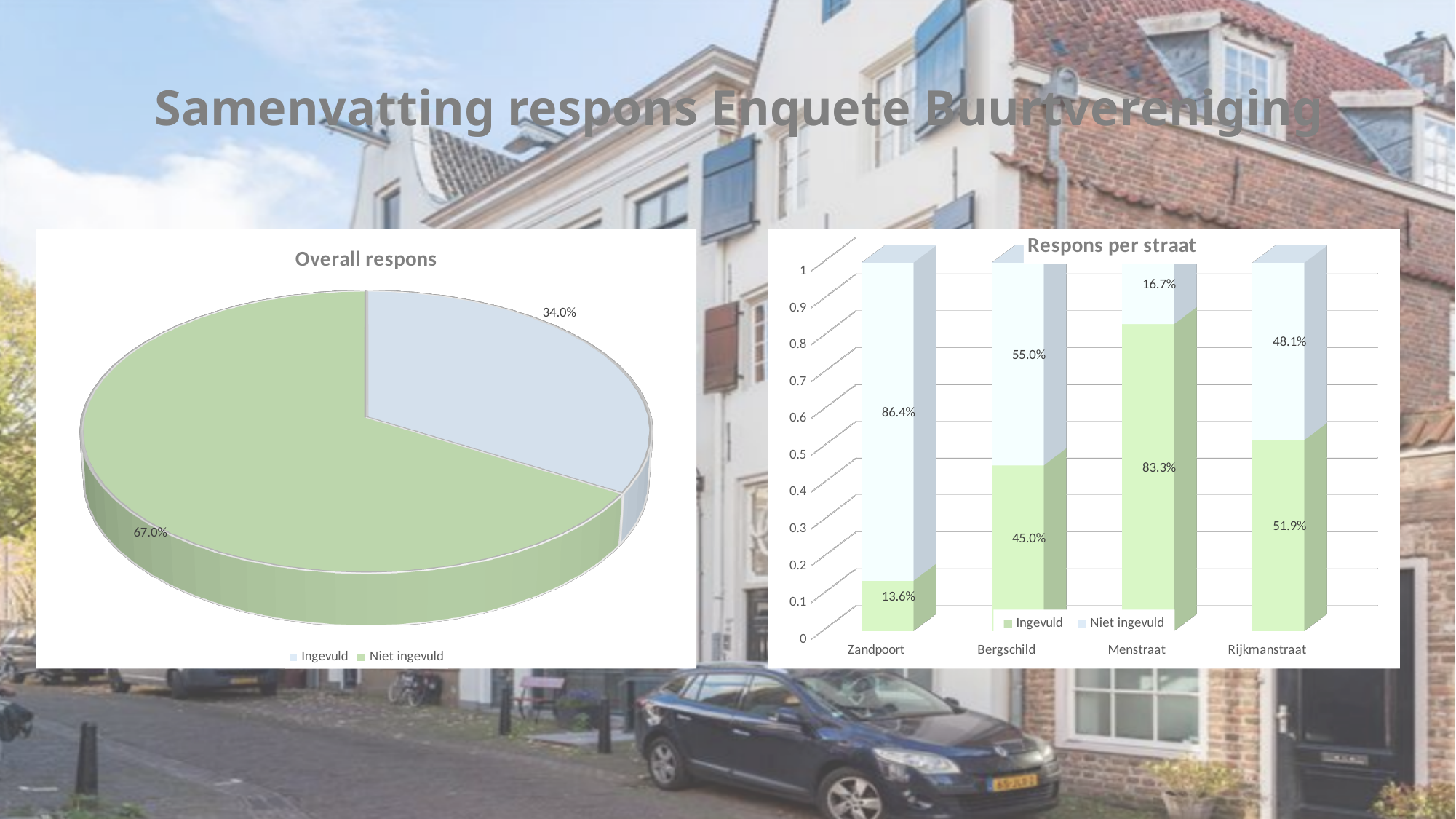
In the 'Respons per straat' chart, what is the Ingevuld value for Menstraat? 83.3% How many series does the legend of the 'Respons per straat' chart list? 2 In the 'Overall respons' pie chart, what share is labelled for Ingevuld? 34.0% In the 'Respons per straat' chart, what is the Ingevuld value for Zandpoort? 13.6% What kind of chart is 'Overall respons'? Pie chart In the 'Overall respons' pie chart, what share is labelled for Niet ingevuld? 67.0% In the 'Respons per straat' chart, is the Ingevuld value larger for Bergschild or for Rijkmanstraat? Rijkmanstraat In the 'Respons per straat' chart, what is the Niet ingevuld value for Bergschild? 55.0% In the 'Respons per straat' chart, which street has the highest Ingevuld value? Menstraat In the 'Respons per straat' chart, what is the difference between the Niet ingevuld values for Zandpoort and Rijkmanstraat? 38.3% In the 'Respons per straat' chart, which street has the lowest Ingevuld value? Zandpoort How many streets are shown on the x axis of the 'Respons per straat' chart? 4